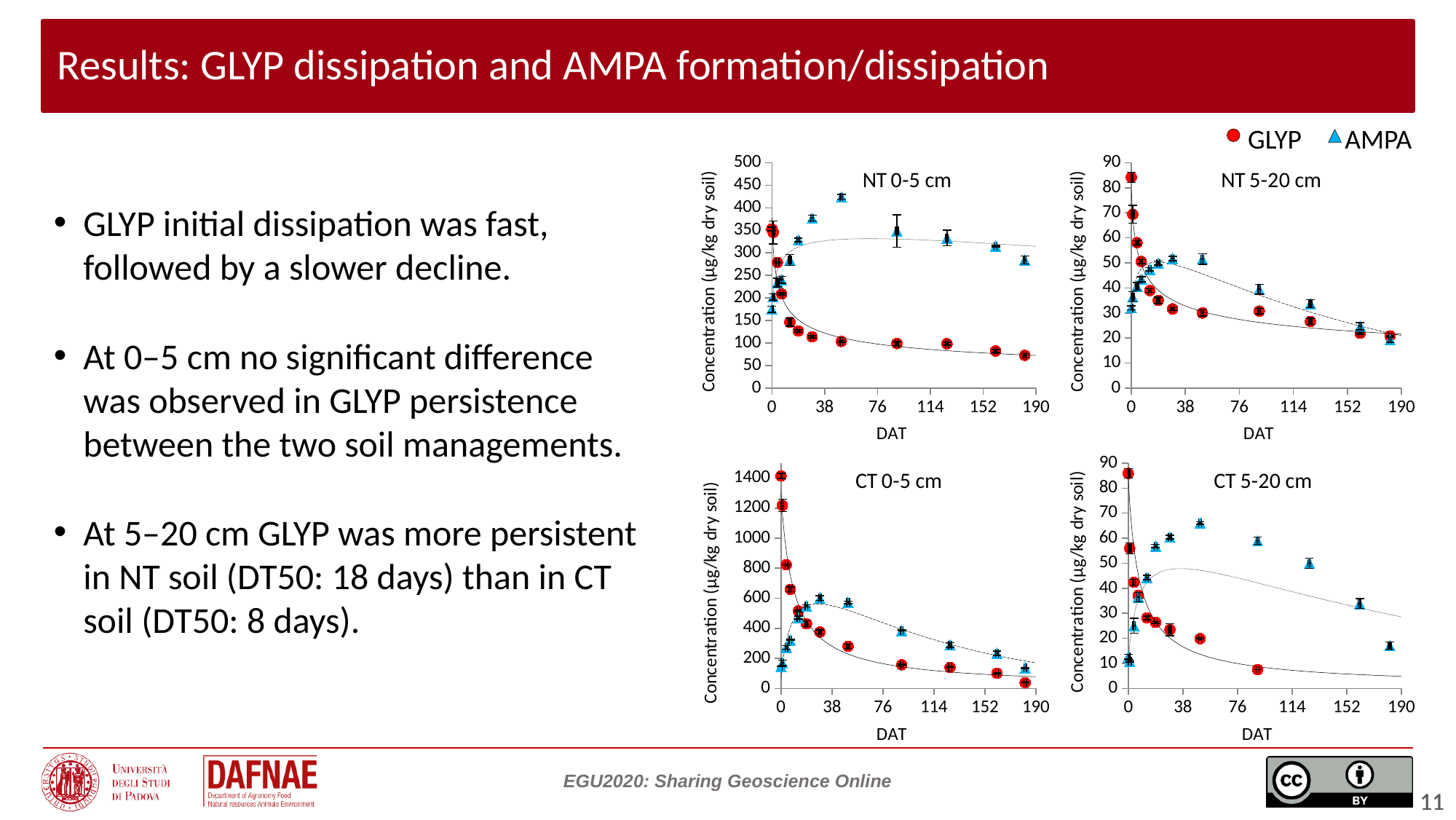
How many chart panels are shown on the slide? 4 How many series does the legend list? 2 In the NT 0-5 cm chart, does the GLYP concentration rise or fall as DAT increases? fall What kind of chart is used in the four panels on the slide? scatter chart In the CT 0-5 cm chart, is the peak AMPA value greater or less than 400? greater In the NT 5-20 cm chart, is the GLYP value at DAT 0 greater or less than 70? greater In the NT 0-5 cm chart, is the GLYP value at DAT 0 greater or less than 300? greater What is the label on the x axis of each chart? DAT In the CT 0-5 cm chart, which series has the higher value at DAT 0, GLYP or AMPA? GLYP What are the two series named in the legend? GLYP and AMPA In the NT 0-5 cm chart, which series has the higher value at the last sampling point near DAT 190, GLYP or AMPA? AMPA